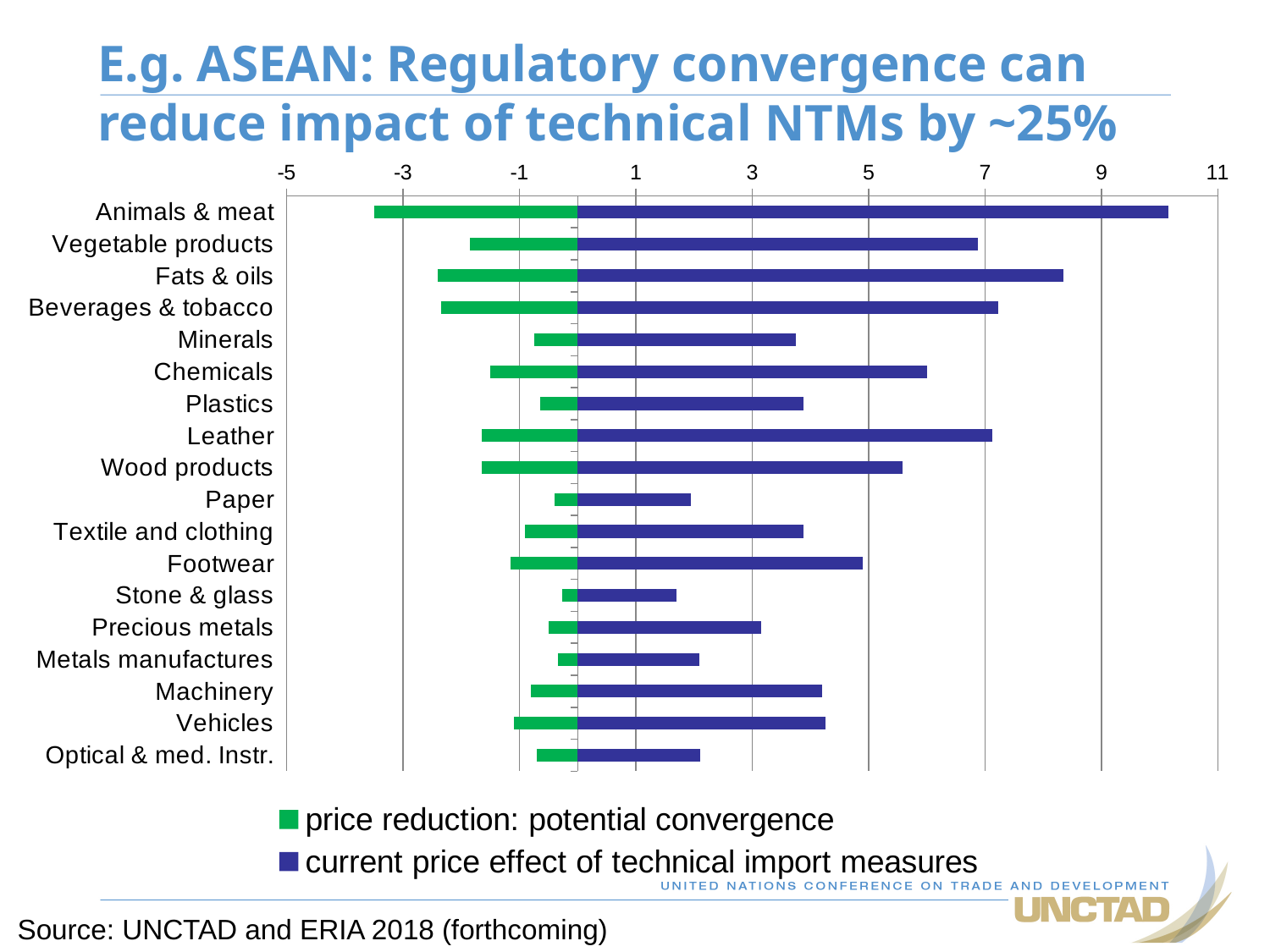
Which has a larger current price effect of technical import measures, Fats & oils or Vegetable products? Fats & oils Which has a larger current price effect of technical import measures, Leather or Wood products? Leather What kind of chart is shown on the slide? bar chart Which category has the highest current price effect of technical import measures? Animals & meat Is the current price effect of technical import measures for Fats & oils greater or less than 7? greater How many series does the legend list? 2 Is the current price effect of technical import measures for Paper greater or less than 3? less Which colour represents the series 'price reduction: potential convergence'? green Is the current price effect of technical import measures for Animals & meat greater or less than 9? greater Which category has the largest price reduction from potential convergence (the longest green bar)? Animals & meat How many product categories are listed on the chart? 18